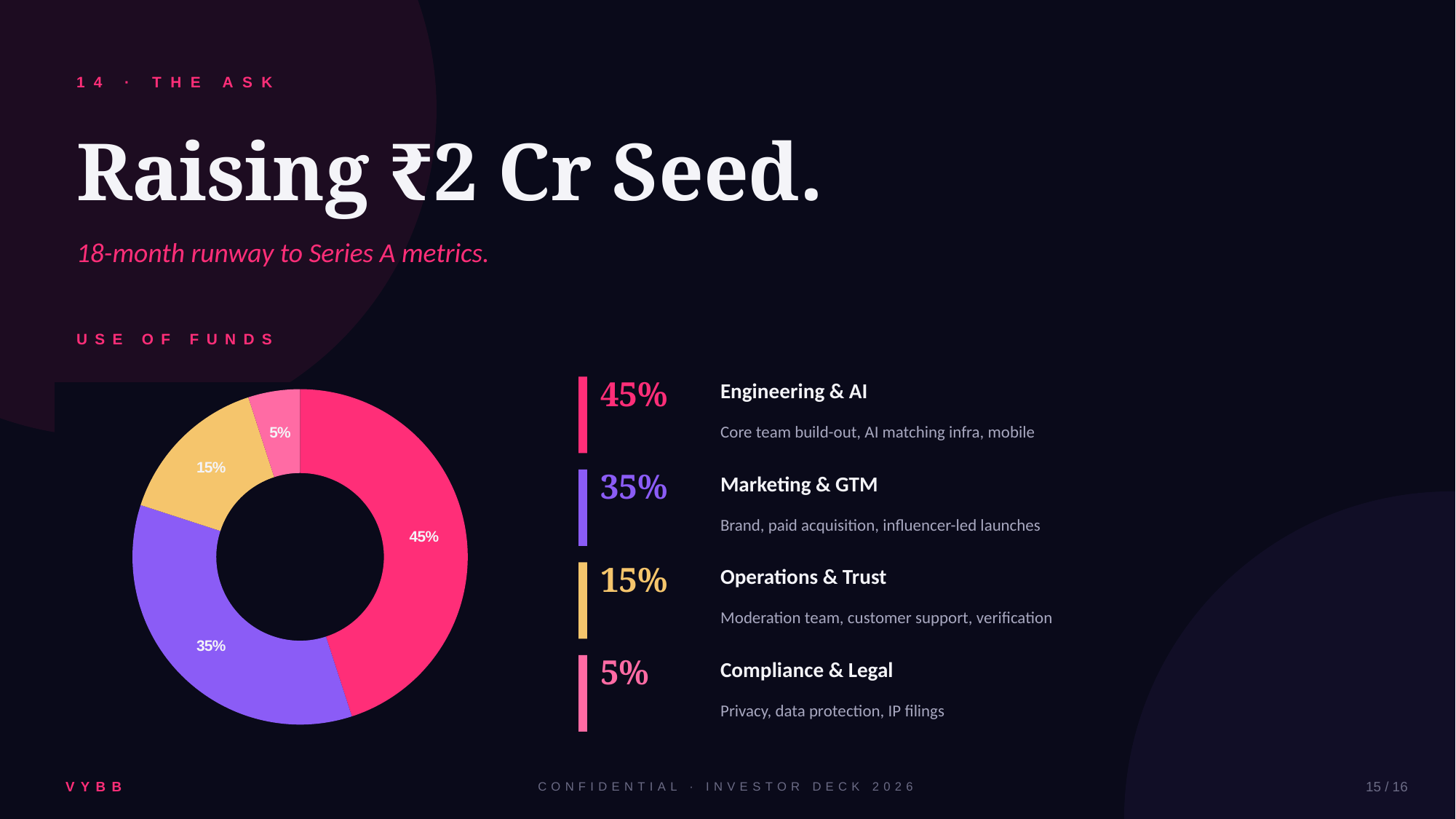
How many categories are shown in the use of funds chart? 4 What share of funds goes to Engineering & AI? 45% What is the difference between the Operations & Trust share and the Compliance & Legal share? 10% What colour is the Operations & Trust slice in the chart? Yellow What share of funds goes to Compliance & Legal? 5% What kind of chart is used to show the use of funds? Donut (pie) chart Which use of funds receives the largest share? Engineering & AI Which use of funds receives the smallest share? Compliance & Legal What share of funds goes to Operations & Trust? 15% What share of funds goes to Marketing & GTM? 35% Which receives a larger share of funds, Marketing & GTM or Operations & Trust? Marketing & GTM What is the difference between the Engineering & AI share and the Marketing & GTM share? 10%